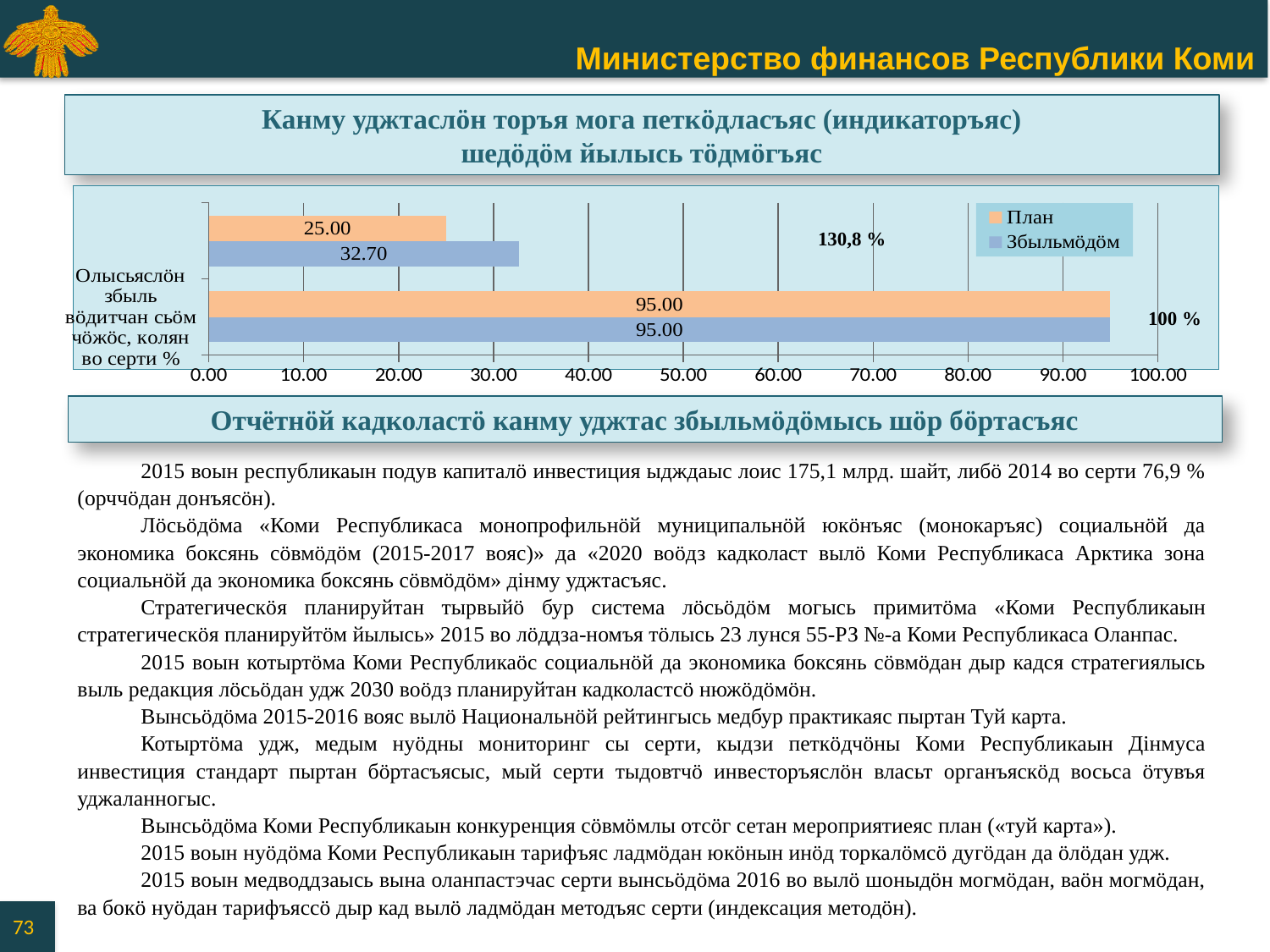
What percentage annotation is printed next to the upper pair of bars? 130,8 % What is the Збыльмöдöм value for the category "Олысьяслöн збыль вöдитчан сьöм чöжöс, колян во серти %"? 95.00 How many series does the chart legend list? 2 How many categories (pairs of bars) are plotted in the chart? 2 Is the Збыльмöдöм value for the upper pair of bars greater or less than 30.00? greater What is the План value for the category "Олысьяслöн збыль вöдитчан сьöм чöжöс, колян во серти %"? 95.00 What is the План value for the upper pair of bars in the chart? 25.00 What kind of chart is shown on the slide? bar chart What are the two series named in the chart legend? План and Збыльмöдöм For the upper pair of bars, which is larger: the План value or the Збыльмöдöм value? Збыльмöдöм What is the Збыльмöдöм value for the upper pair of bars in the chart? 32.70 For the upper pair of bars, what is the difference between the Збыльмöдöм value and the План value? 7.70